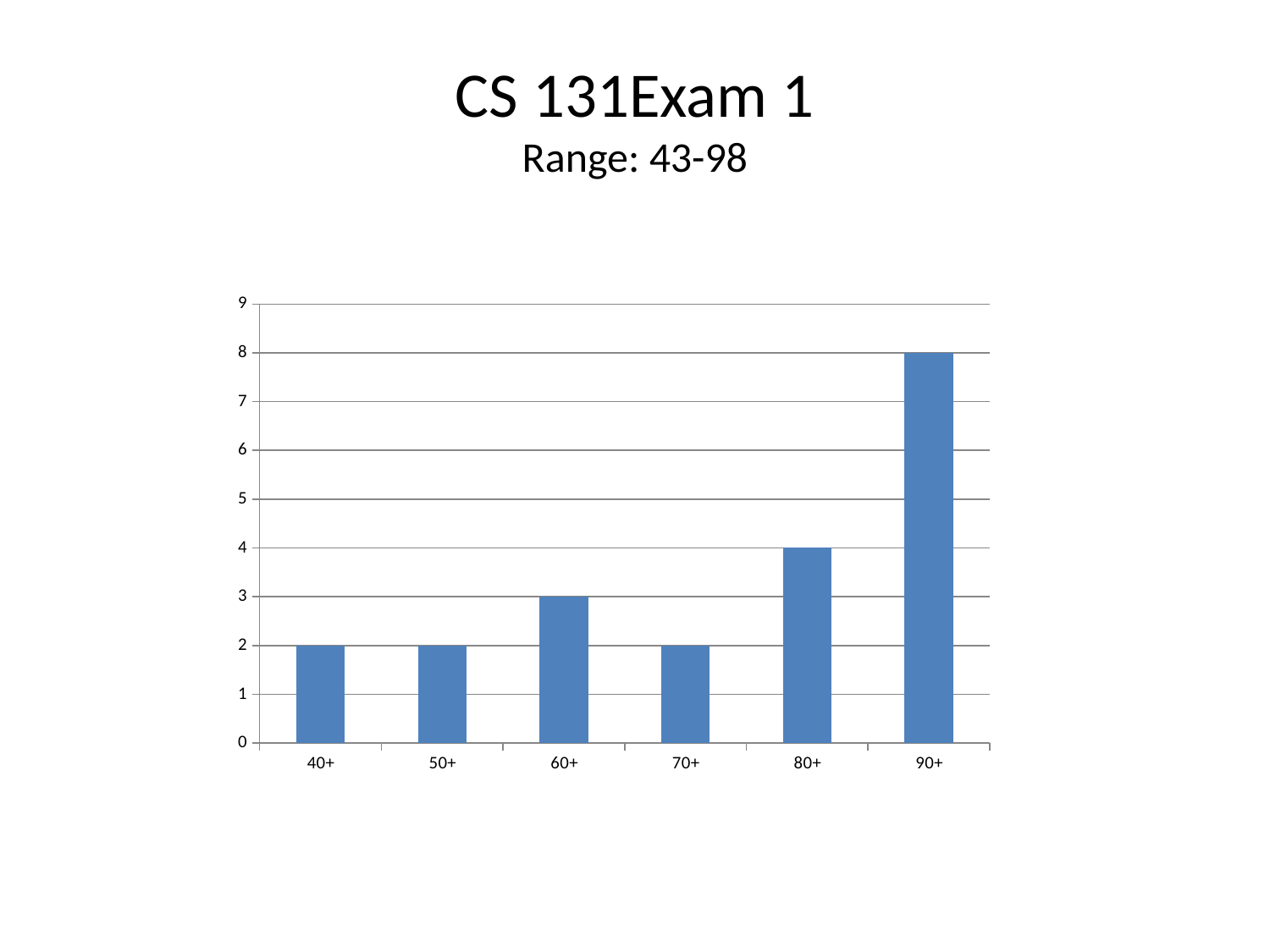
What is the difference between the values for 90+ and 80+? 4 What is the value for the 80+ category? 4 What is the title of the slide? CS 131Exam 1 Which category has the highest value? 90+ What is the value for the 40+ category? 2 What is the value for the 60+ category? 3 Do the values rise or fall from 70+ to 90+? rise What is the value for the 90+ category? 8 What kind of chart is shown on the slide? bar chart Which is larger, the value for 80+ or the value for 60+? 80+ Is the value for 90+ greater or less than 5? greater How many categories are shown on the x axis? 6